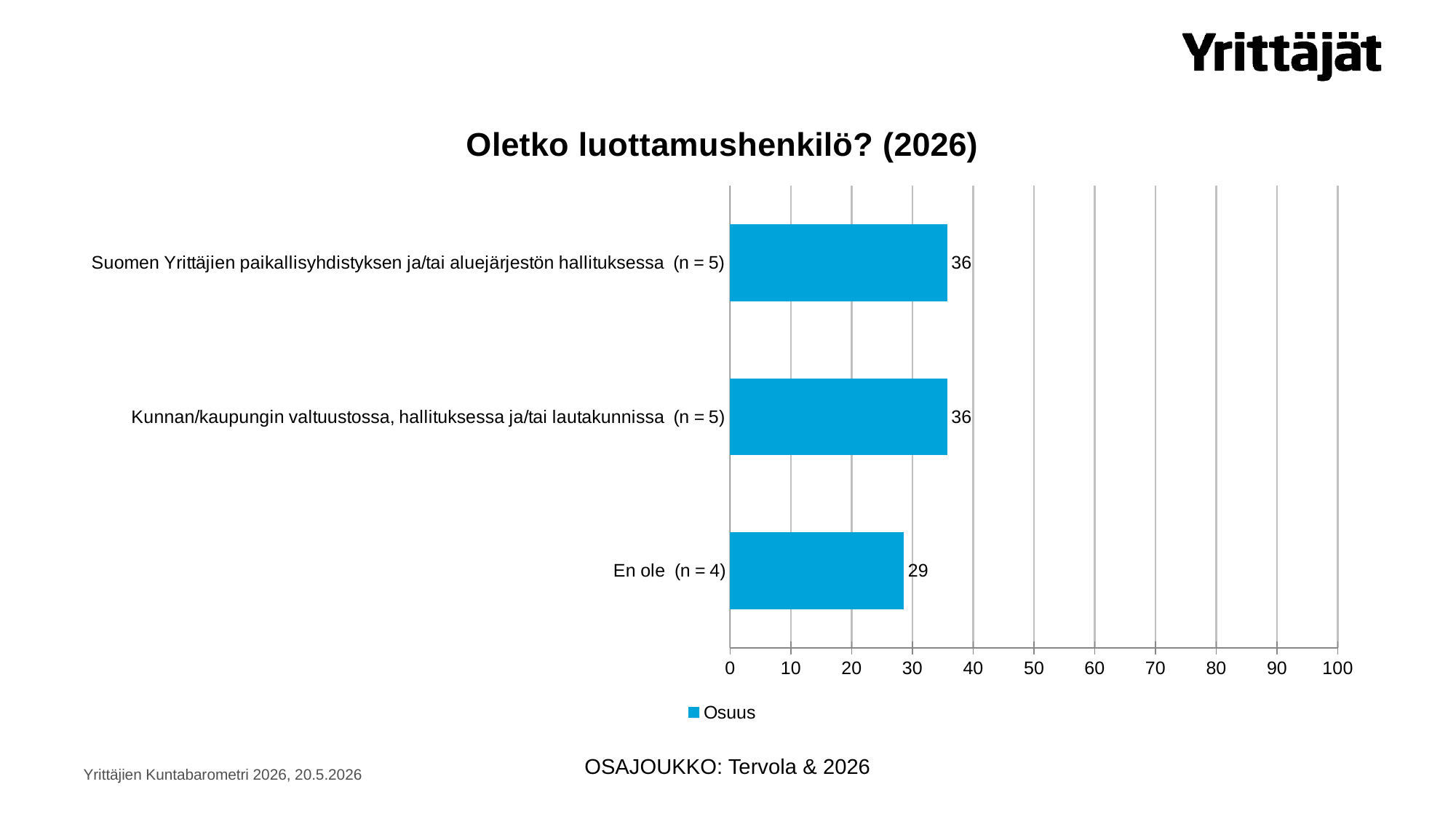
How many categories are shown in the chart? 3 What is the difference between the value for "Kunnan/kaupungin valtuustossa, hallituksessa ja/tai lautakunnissa" and the value for "En ole"? 7 Is the value for "En ole" greater or less than 30? less What is the title of the chart? Oletko luottamushenkilö? (2026) What is the value for "En ole (n = 4)"? 29 Which is larger: the value for "En ole" or the value for "Suomen Yrittäjien paikallisyhdistyksen ja/tai aluejärjestön hallituksessa"? Suomen Yrittäjien paikallisyhdistyksen ja/tai aluejärjestön hallituksessa What is the value for "Kunnan/kaupungin valtuustossa, hallituksessa ja/tai lautakunnissa (n = 5)"? 36 Which category has the lowest value? En ole (n = 4) Is the value for "Kunnan/kaupungin valtuustossa, hallituksessa ja/tai lautakunnissa" greater or less than 30? greater What kind of chart is shown on the slide? bar chart What is the value for "Suomen Yrittäjien paikallisyhdistyksen ja/tai aluejärjestön hallituksessa (n = 5)"? 36 How many series does the legend list? 1